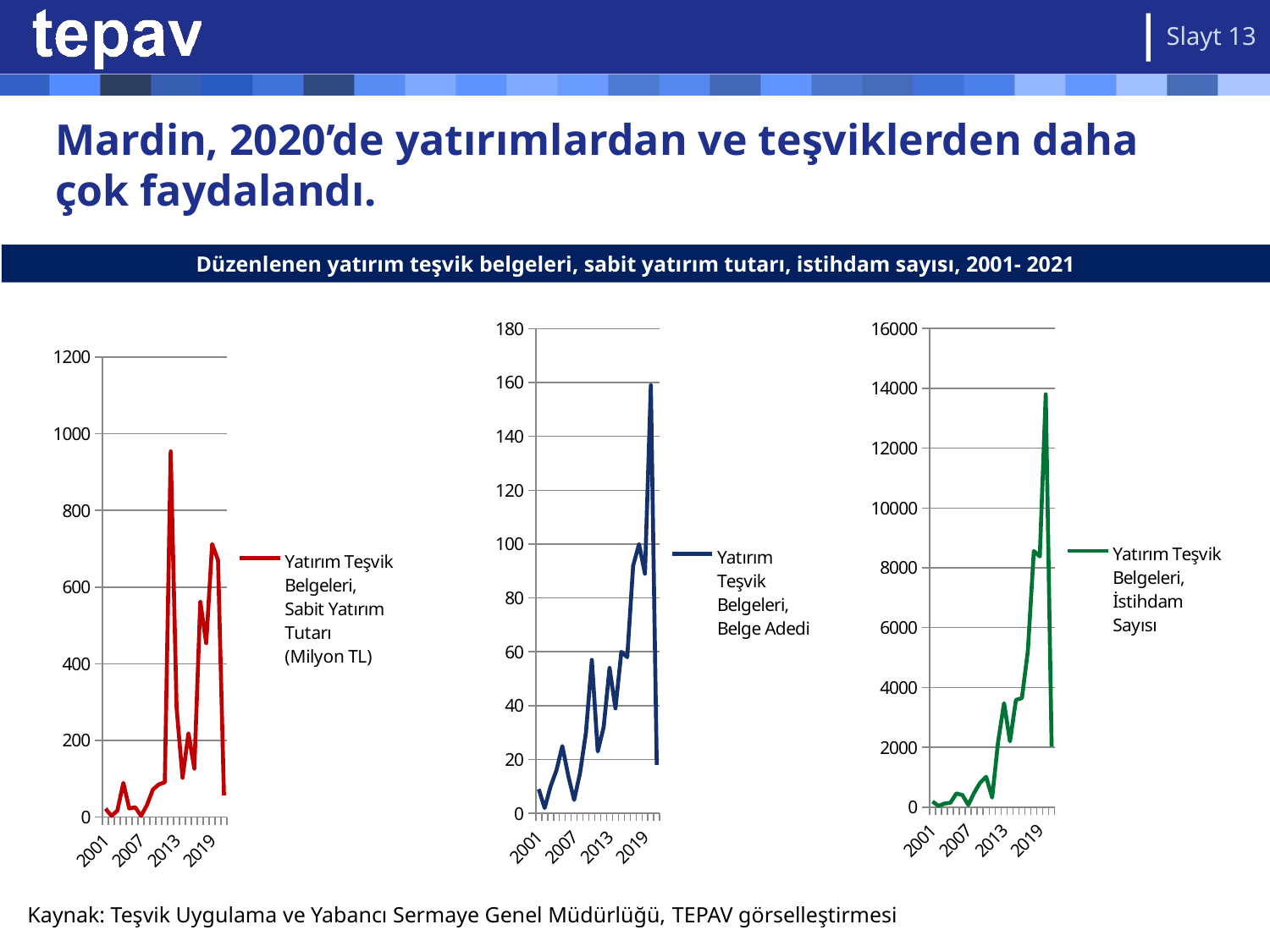
What kind of chart is the left chart (Sabit Yatırım Tutarı)? line chart What is the legend entry of the right chart? Yatırım Teşvik Belgeleri, İstihdam Sayısı In the right chart (İstihdam Sayısı), is the value for 2001 greater or less than 2000? less In the middle chart (Belge Adedi), do the values overall rise or fall from 2001 to 2019? rise How many series does the legend of the middle chart (Belge Adedi) list? 1 In the middle chart (Belge Adedi), is the highest value greater or less than 140? greater In the left chart (Sabit Yatırım Tutarı), is the highest value greater or less than 800? greater In the right chart (İstihdam Sayısı), do the values overall rise or fall from 2001 to 2019? rise How many charts are shown on the slide? 3